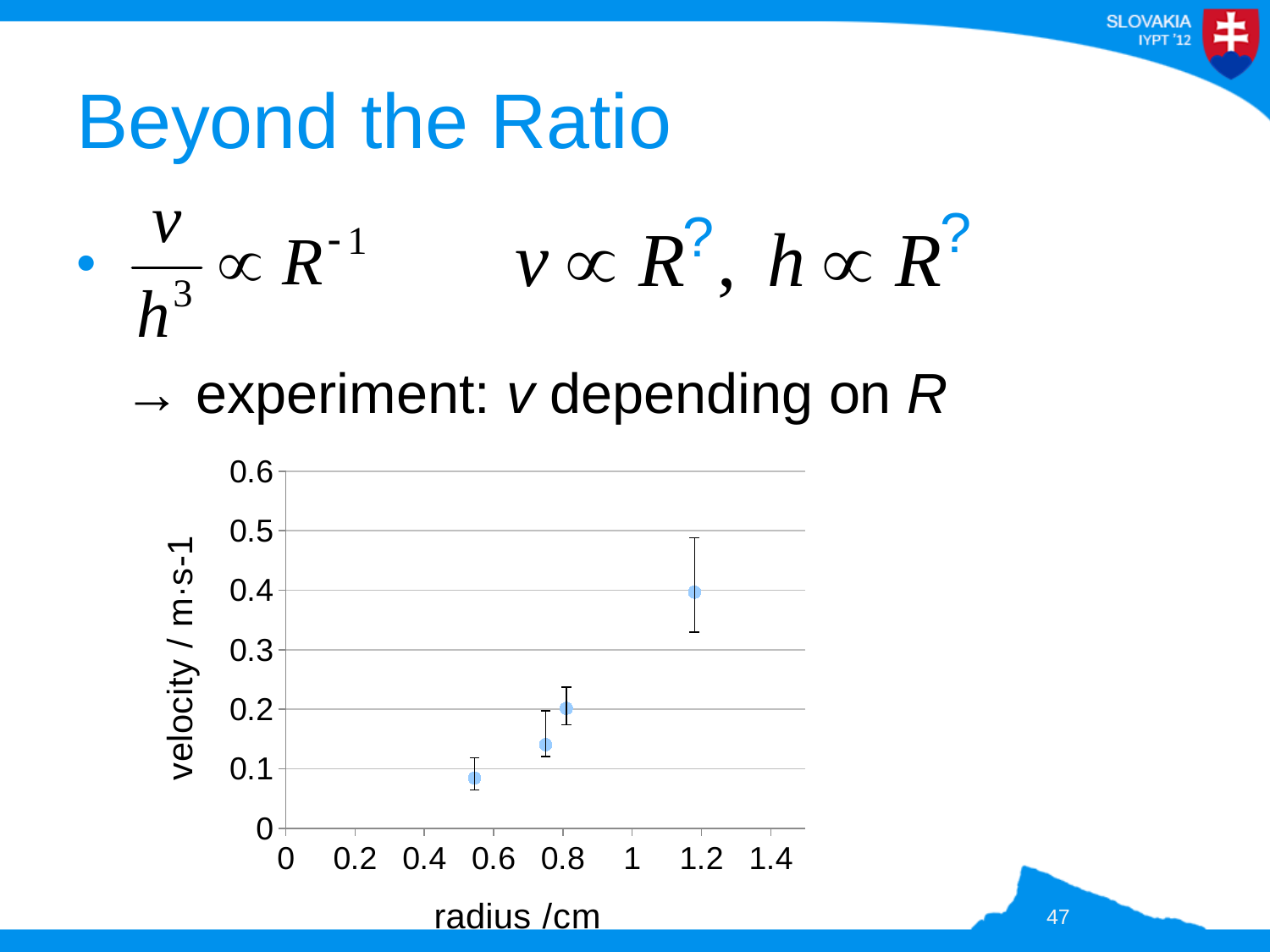
Is the velocity of the data point with the largest radius greater or less than 0.3 m·s-1? greater How many data points are plotted in the chart? 4 What kind of chart is shown on the slide? scatter plot Is the radius of the data point with the highest velocity greater or less than 1 cm? greater Does the data point with the largest radius also have the highest velocity? yes Are all plotted radius values less than 1.4 cm? yes Do the velocity values rise or fall as the radius increases? rise What is the label of the x-axis? radius /cm What is the label of the y-axis? velocity / m·s-1